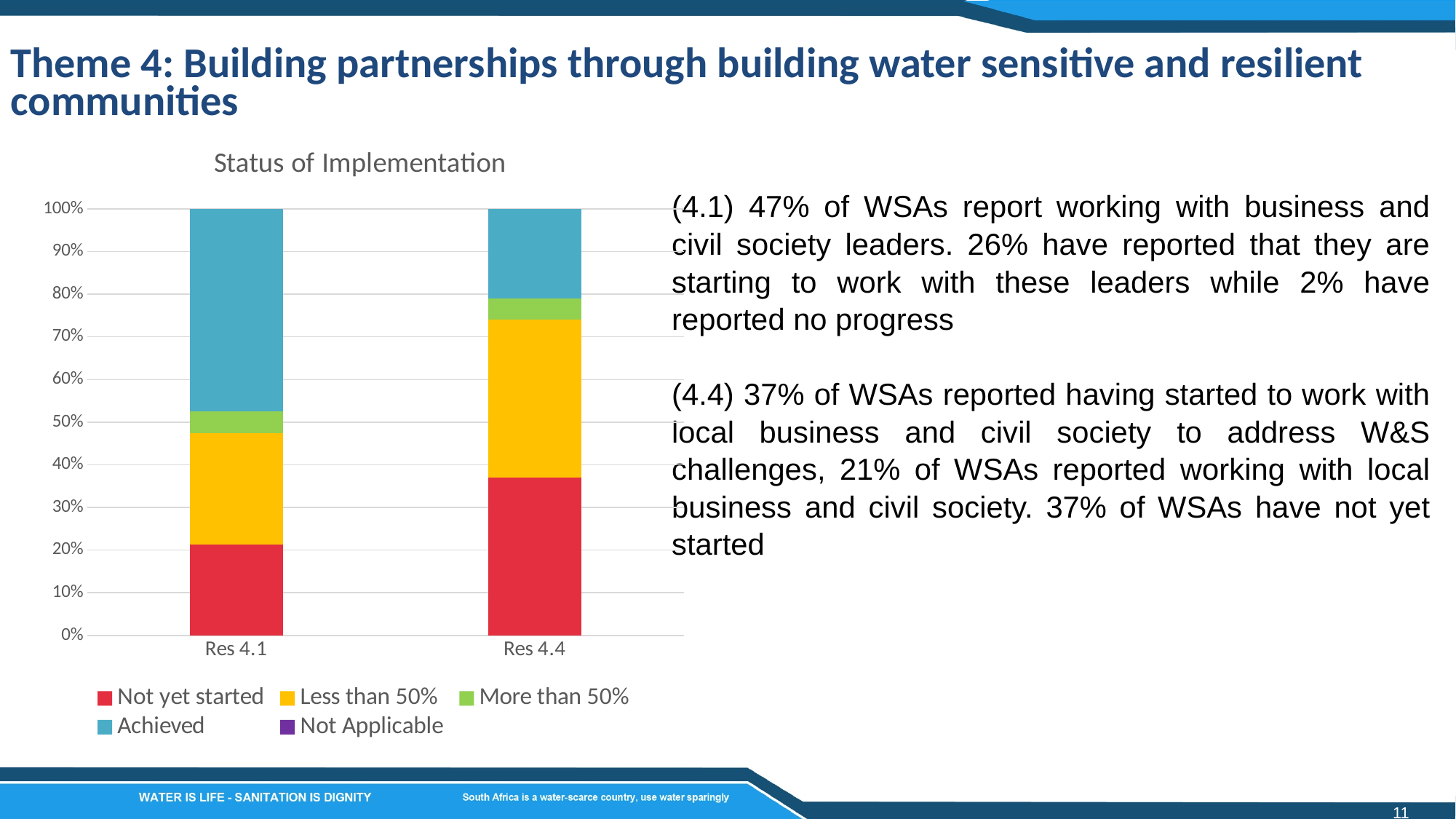
What is the title of the chart? Status of Implementation Which category has the larger 'Not yet started' segment, Res 4.1 or Res 4.4? Res 4.4 What kind of chart is shown on the slide? Stacked bar chart How many series does the chart's legend list? 5 Which category has the larger 'Achieved' segment, Res 4.1 or Res 4.4? Res 4.1 Is the 'Achieved' segment for Res 4.1 greater or less than 40%? greater How many categories are shown on the x axis of the chart? 2 Which colour represents 'Not yet started' in the chart? Red Is the 'Not yet started' segment for Res 4.1 greater or less than 30%? less Which series makes up the largest segment of the Res 4.1 bar? Achieved What value does the top of each stacked bar reach on the y axis? 100% Is the 'Not yet started' segment for Res 4.4 greater or less than 30%? greater